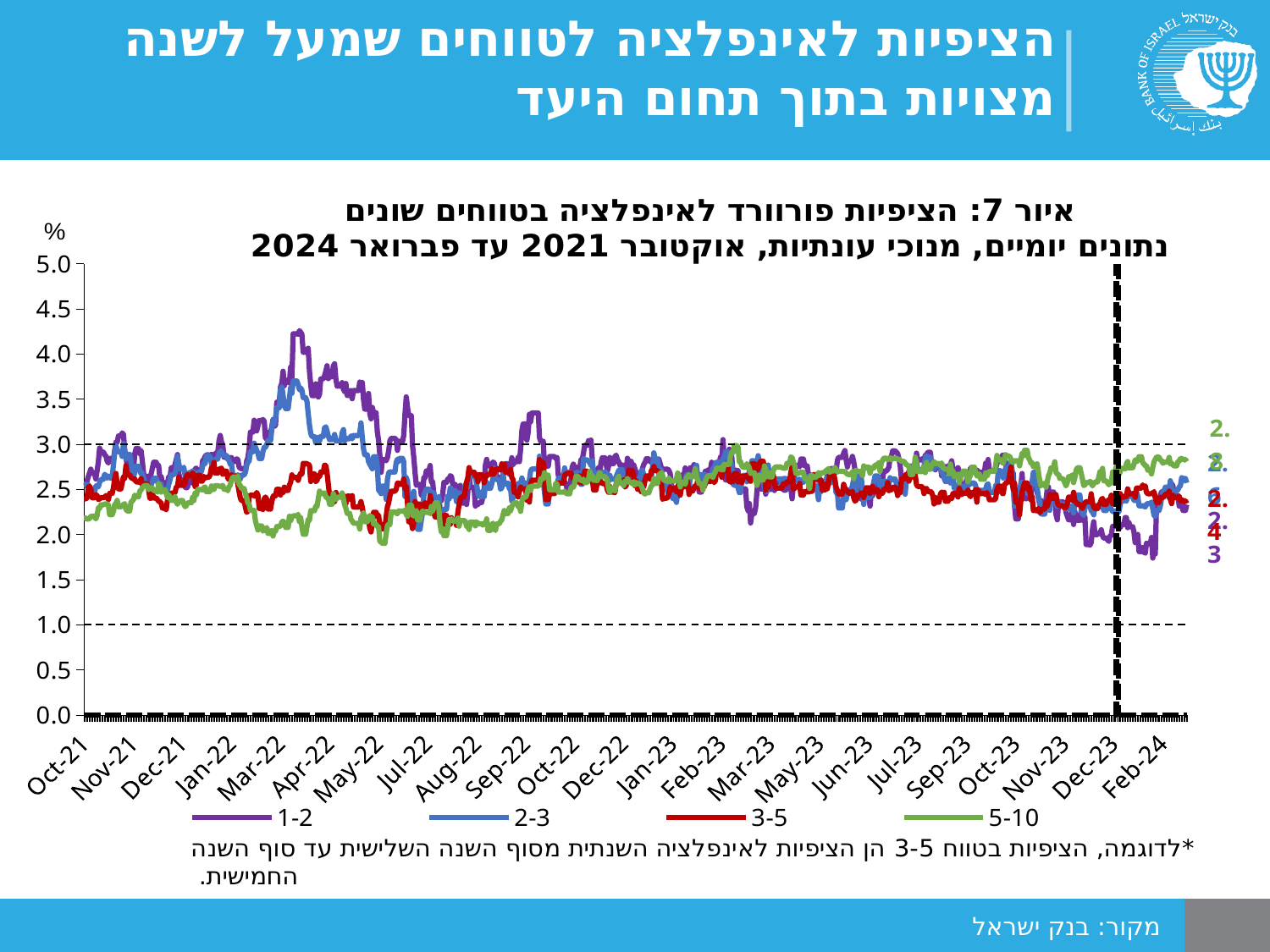
Which series reaches the highest peak over the whole period? 1-2 What are the four series listed in the legend? 1-2, 2-3, 3-5, 5-10 Is the value of the 5-10 series in Mar-22 greater or less than 2.5? less How many series does the legend list? 4 Which series is highest at the end of the period (Feb-24)? 5-10 Is the peak value of the 1-2 series around Apr-22 greater or less than 4.0? greater Does the 1-2 series rise or fall between Apr-22 and Jul-22? Fall Is the peak value of the 2-3 series around Apr-22 greater or less than 3.5? greater In Apr-22, which series is higher: 1-2 or 5-10? 1-2 At what values are the two horizontal dashed lines drawn on the chart? 1.0 and 3.0 What kind of chart is shown on the slide? Line chart